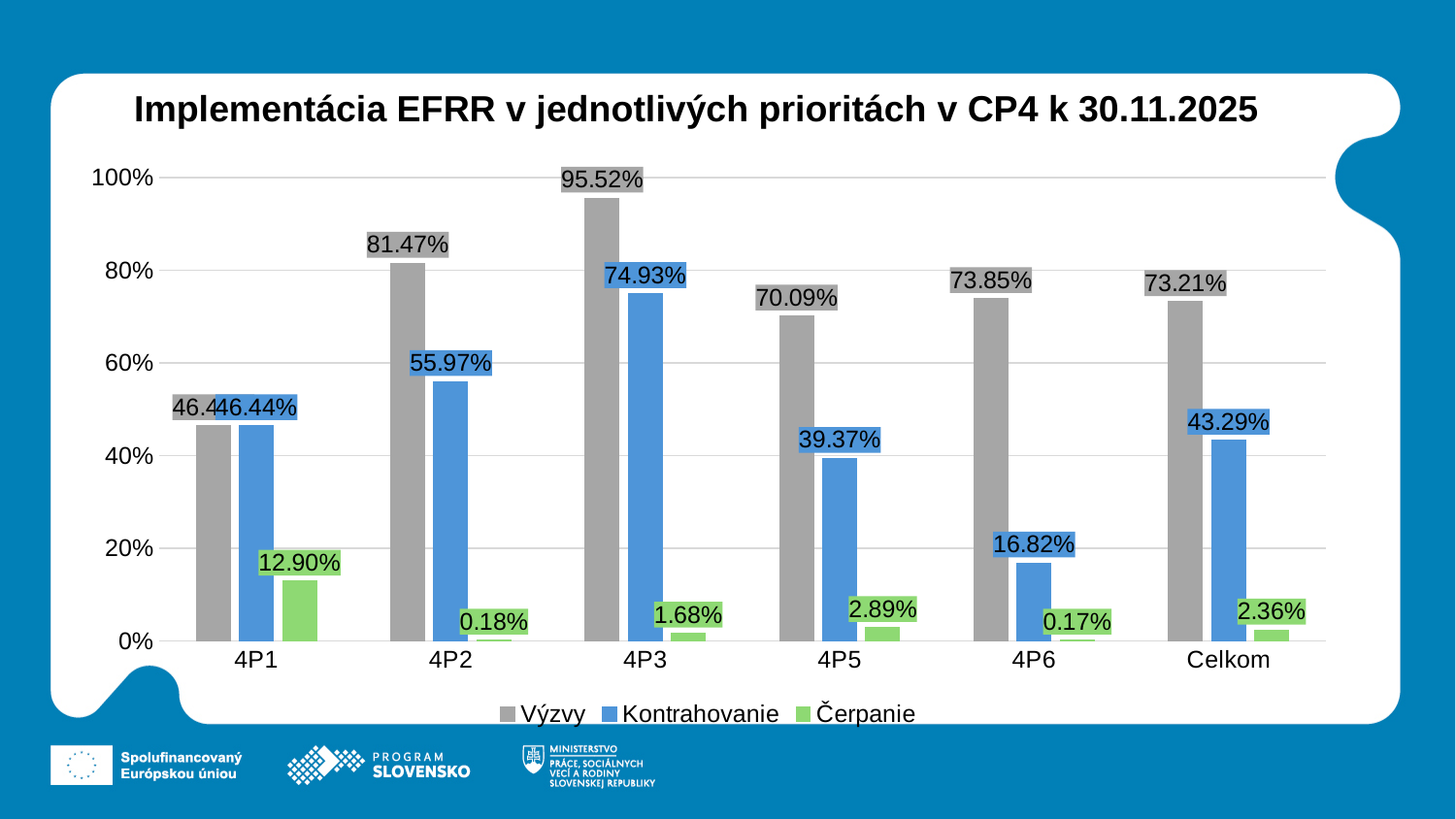
Which category has the lowest Čerpanie value? 4P6 Is the Kontrahovanie value for 4P3 greater or less than 60%? greater What is the title of the chart? Implementácia EFRR v jednotlivých prioritách v CP4 k 30.11.2025 What is the difference between the Výzvy and Kontrahovanie values for 4P5? 30.72% How many series does the legend list? 3 What type of chart is shown on the slide? bar chart Which category has the highest Výzvy value? 4P3 What is the Výzvy value for 4P3? 95.52% How many categories are shown on the x axis? 6 What is the Čerpanie value for Celkom? 2.36% Which is larger, the Kontrahovanie value for 4P6 or the Kontrahovanie value for Celkom? Celkom What is the Kontrahovanie value for 4P2? 55.97%